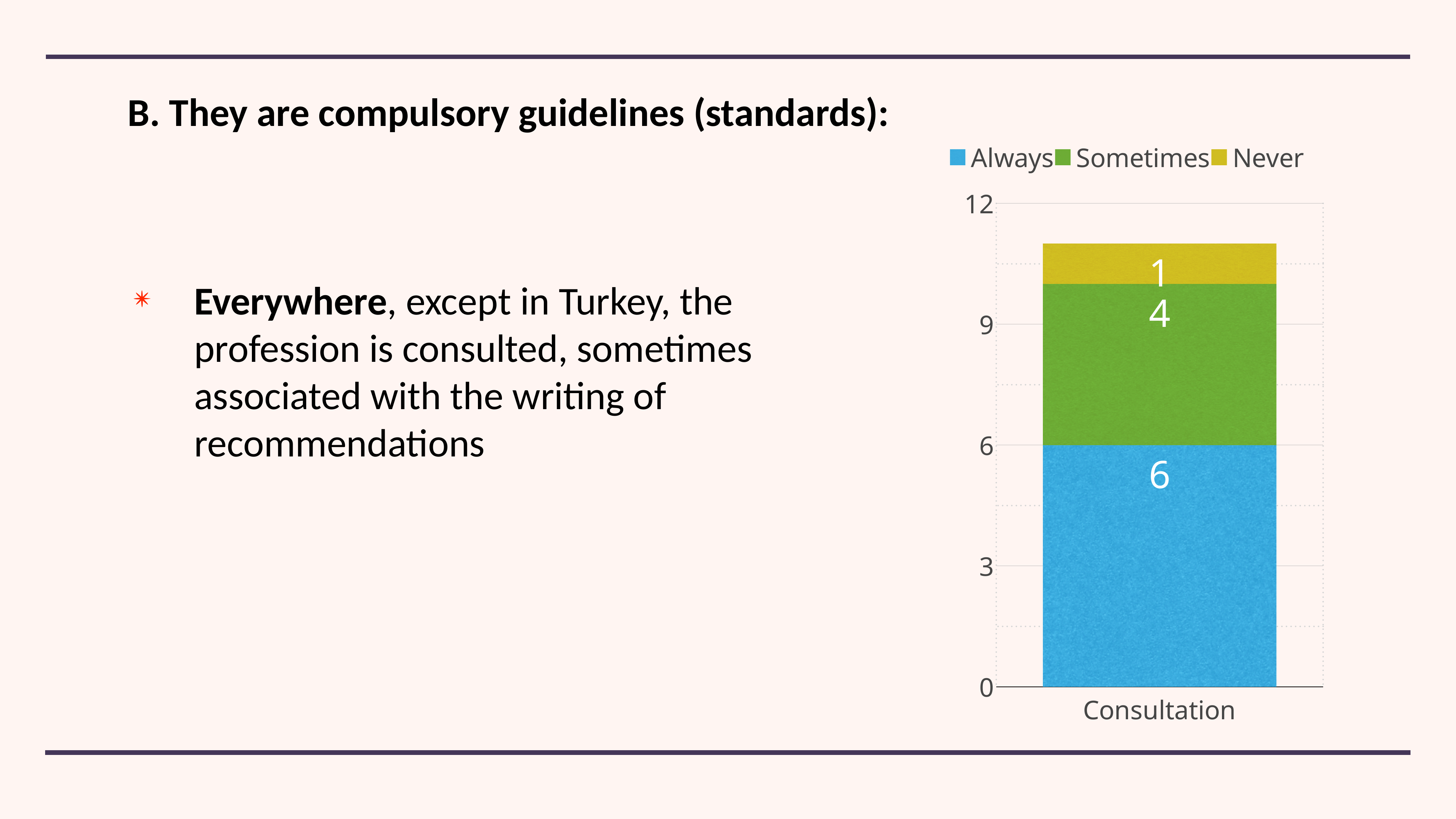
What colour represents the Always series? Blue What is the value for Sometimes in the Consultation bar? 4 What is the total of the stacked Consultation bar? 11 What kind of chart is shown on the slide? Stacked bar chart Which is larger, the Sometimes value or the Never value? Sometimes How many categories are shown on the x axis? 1 How many series does the legend list? 3 What is the difference between the Always and Sometimes values? 2 Which series has the highest value in the Consultation bar? Always Which series has the lowest value in the Consultation bar? Never What is the value for Always in the Consultation bar? 6 What is the value for Never in the Consultation bar? 1